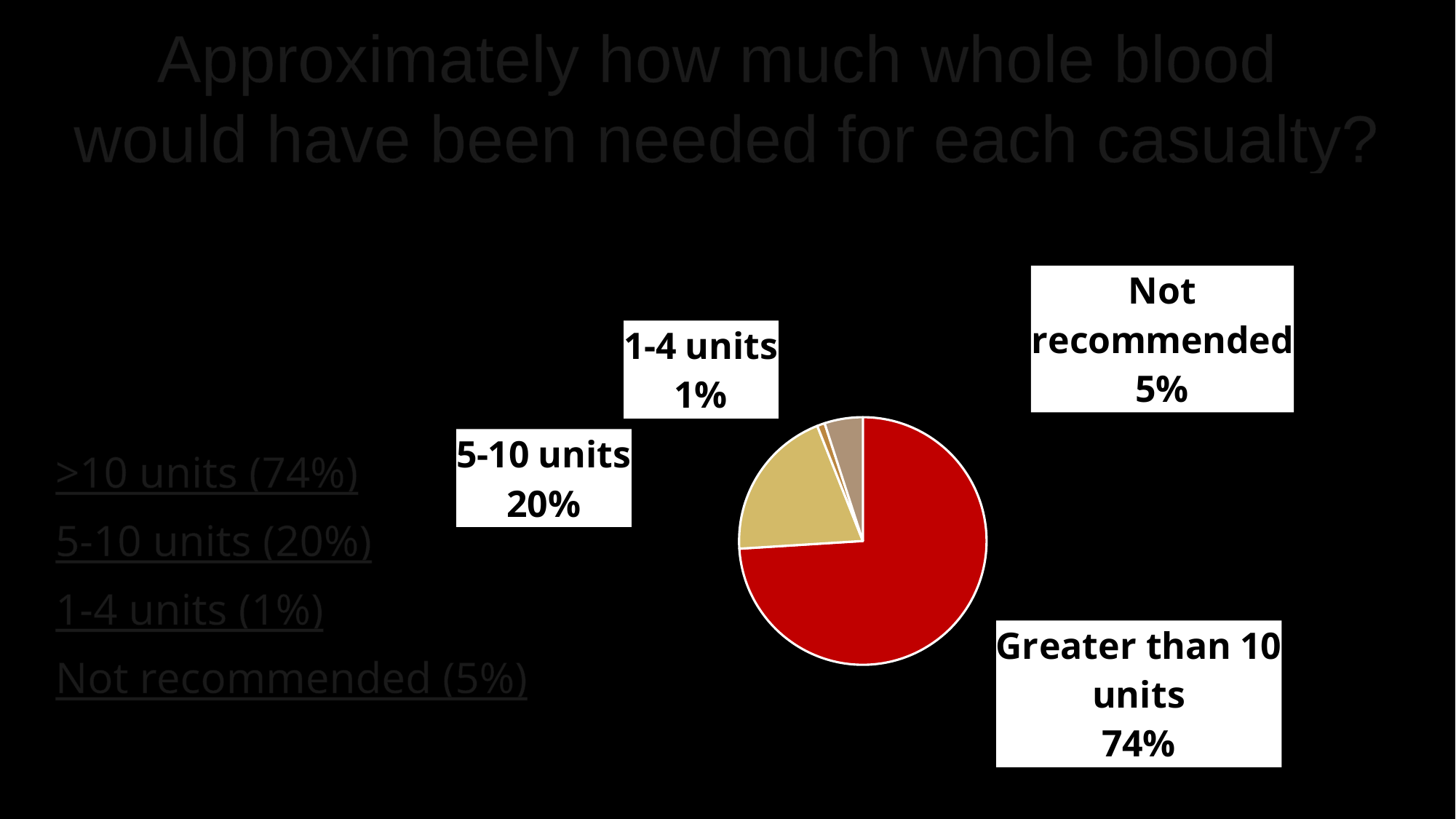
What colour is the slice for 'Greater than 10 units'? red What share of the pie does '5-10 units' represent? 20% What is the difference in percentage points between 'Not recommended' and '1-4 units'? 4 How many slices does the pie chart have? 4 Which category has the largest slice of the pie? Greater than 10 units What share of the pie does '1-4 units' represent? 1% What share of the pie does 'Greater than 10 units' represent? 74% What kind of chart is shown on the slide? pie chart Which category has the smallest slice of the pie? 1-4 units Which is larger, the slice for '5-10 units' or the slice for 'Not recommended'? 5-10 units What is the difference in percentage points between 'Greater than 10 units' and '5-10 units'? 54 What share of the pie does 'Not recommended' represent? 5%